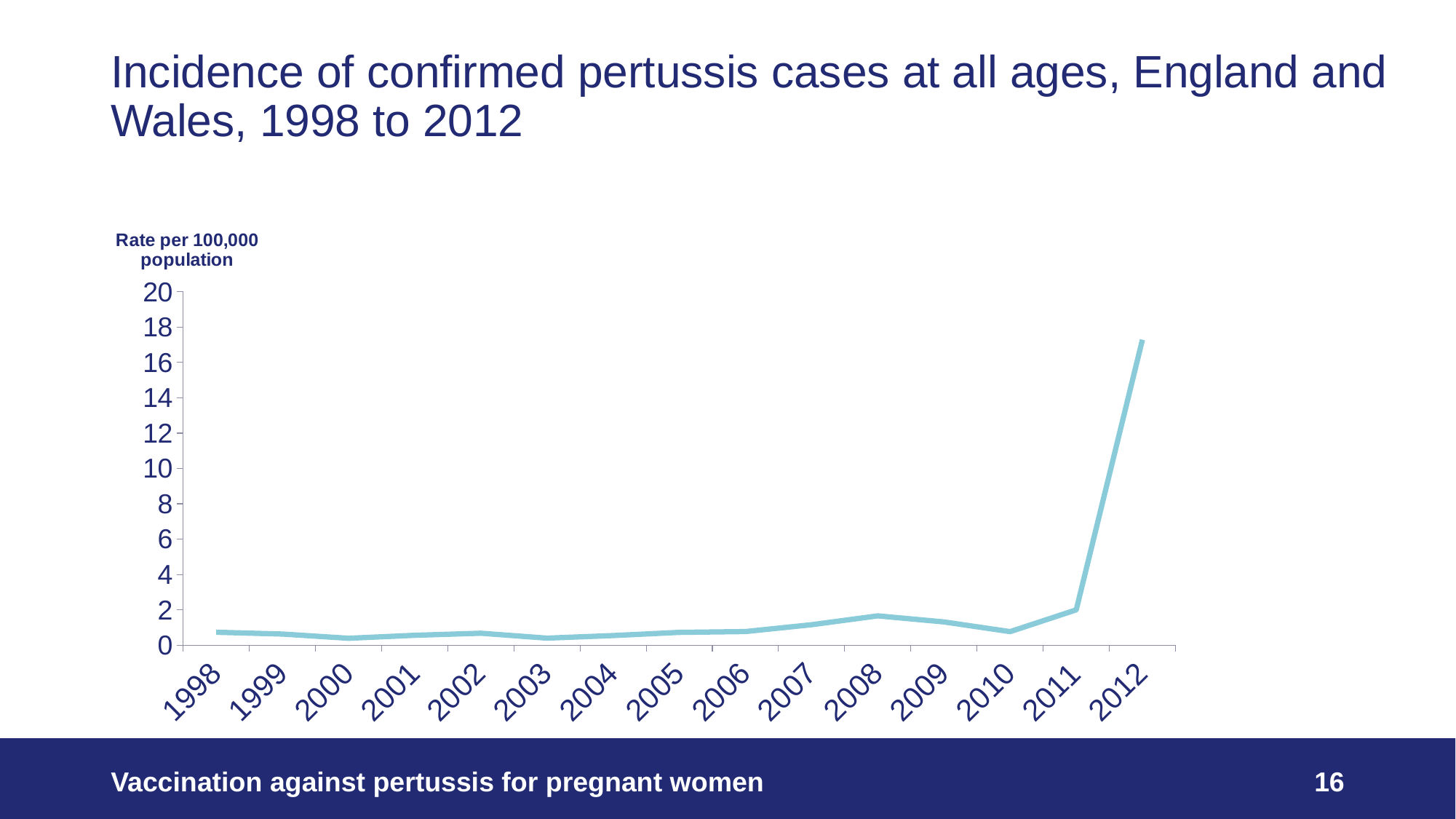
How does the incidence rate change between 2011 and 2012? It rises sharply What is the label on the y axis of the chart? Rate per 100,000 population Is the value for 2012 greater or less than 18? less Which year has the larger value, 2008 or 2010? 2008 Is the value for 2011 greater or less than 4? less Is the value for 2012 greater or less than 16? greater Which year has the larger value, 2011 or 2012? 2012 How many years are plotted along the x axis? 15 Which year has the highest incidence rate of confirmed pertussis cases? 2012 What kind of chart is shown on the slide? line chart